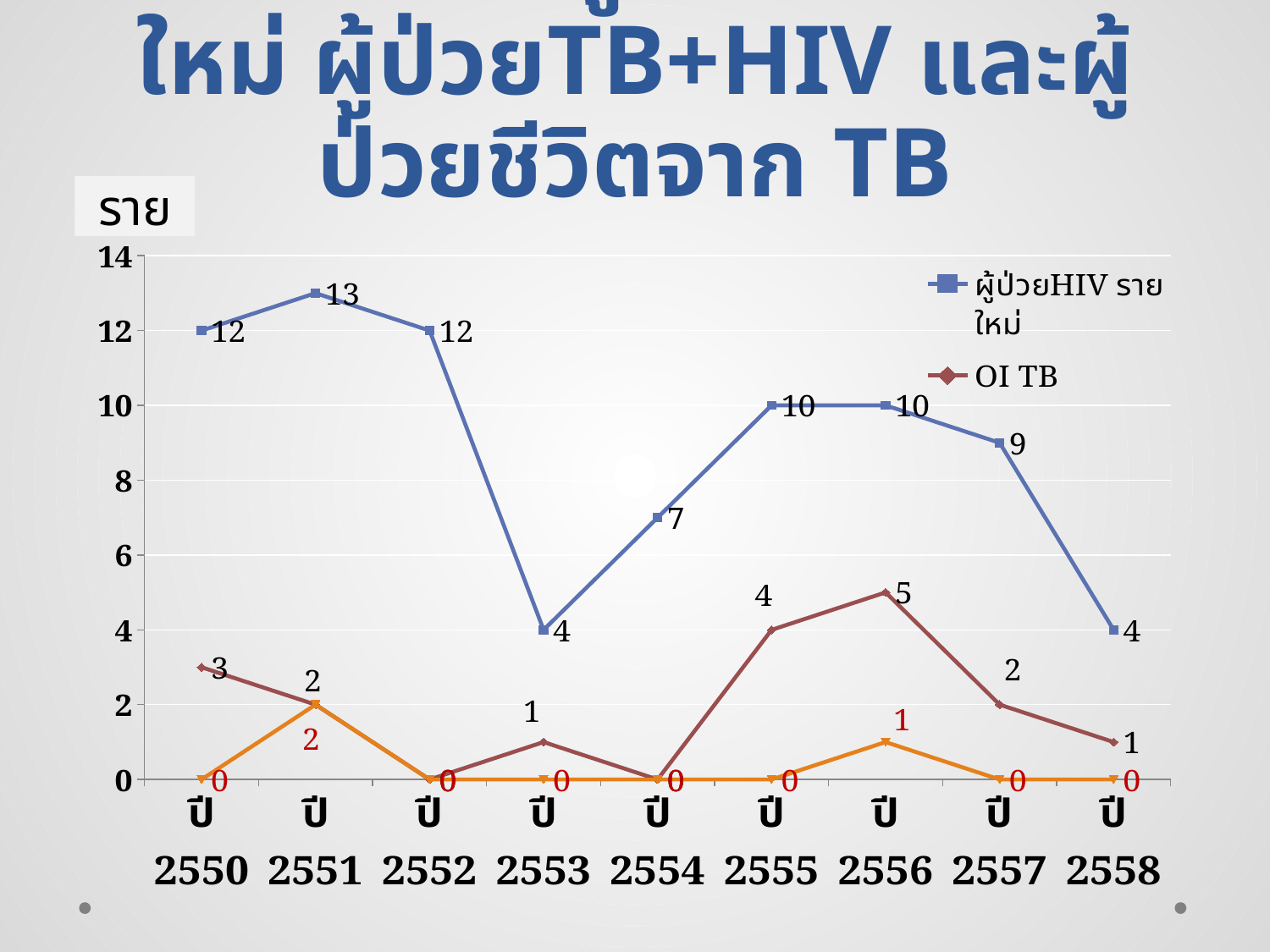
What kind of chart is shown on the slide? line chart What is the value for ผู้ป่วยHIV รายใหม่ in ปี 2551? 13 What is the value for ผู้ป่วยHIV รายใหม่ in ปี 2557? 9 How many years are shown on the x axis? 9 Which year has the larger ผู้ป่วยHIV รายใหม่ value, ปี 2554 or ปี 2555? ปี 2555 In which year is the OI TB series highest? ปี 2556 Does the ผู้ป่วยHIV รายใหม่ series rise or fall from ปี 2556 to ปี 2558? fall In which year is the ผู้ป่วยHIV รายใหม่ series highest? ปี 2551 What is the difference between the OI TB values for ปี 2555 and ปี 2557? 2 How many series does the legend list? 2 What is the value for OI TB in ปี 2556? 5 What is the difference between the ผู้ป่วยHIV รายใหม่ values for ปี 2552 and ปี 2553? 8